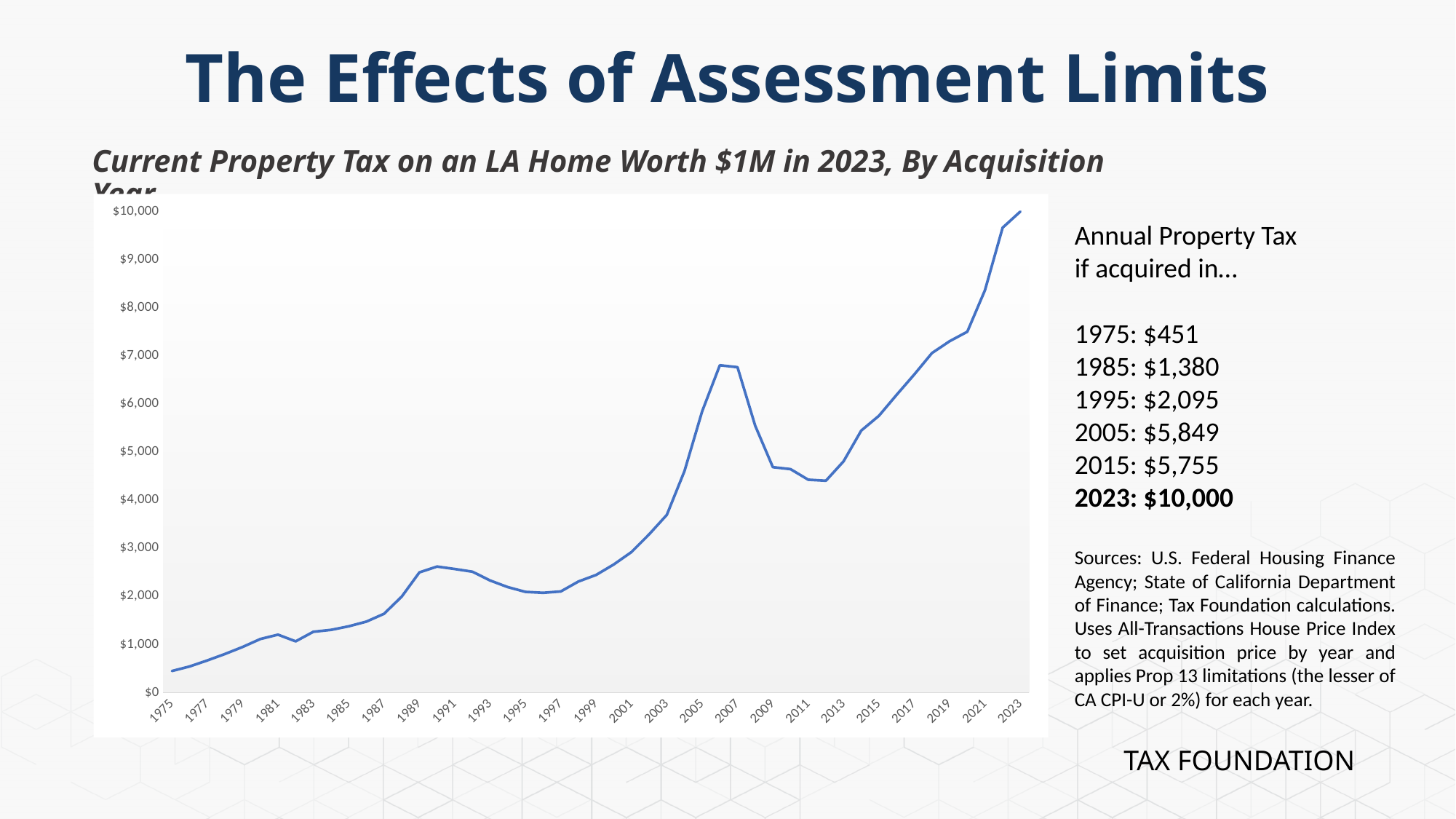
What is the annual property tax for a home acquired in 2005? $5,849 Is the value for 2007 greater or less than $6,000? greater What is the annual property tax for a home acquired in 1995? $2,095 Which acquisition year has the higher annual property tax, 2005 or 2015? 2005 Does the annual property tax rise or fall between 2007 and 2011? fall What is the annual property tax for a home acquired in 1975? $451 Which acquisition year has the lowest annual property tax? 1975 What is the difference in annual property tax between a home acquired in 2023 and one acquired in 1975? $9,549 What kind of chart is shown on the slide? line chart Which acquisition year has the highest annual property tax? 2023 What is the annual property tax for a home acquired in 2023? $10,000 What is the title of the chart? Current Property Tax on an LA Home Worth $1M in 2023, By Acquisition Year